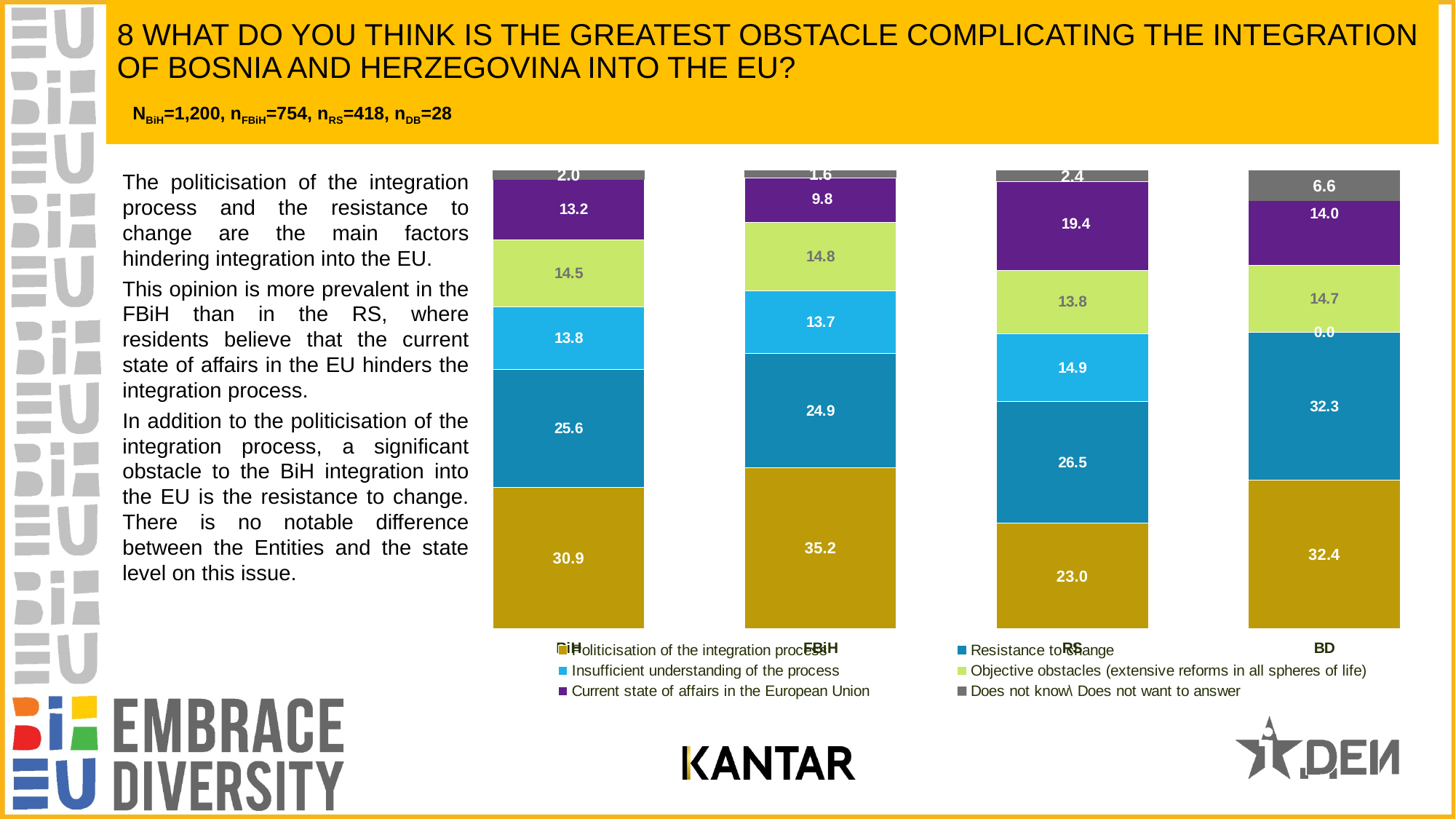
What kind of chart is shown on the slide? Stacked bar chart What is the difference between the 'Politicisation of the integration process' values for FBiH and RS? 12.2 Which is larger: 'Does not know\ Does not want to answer' in BD or in RS? BD What is the value for 'Resistance to change' in RS? 26.5 What is the value for 'Insufficient understanding of the process' in BD? 0.0 In which category is 'Current state of affairs in the European Union' lowest? FBiH How many bars (categories) are plotted in the chart? 4 How many series does the legend list? 6 What is the value for 'Current state of affairs in the European Union' in BD? 14.0 What is the total of the stacked bar for RS? 100.0 What is the value for 'Politicisation of the integration process' in FBiH? 35.2 In which category is 'Politicisation of the integration process' highest? FBiH